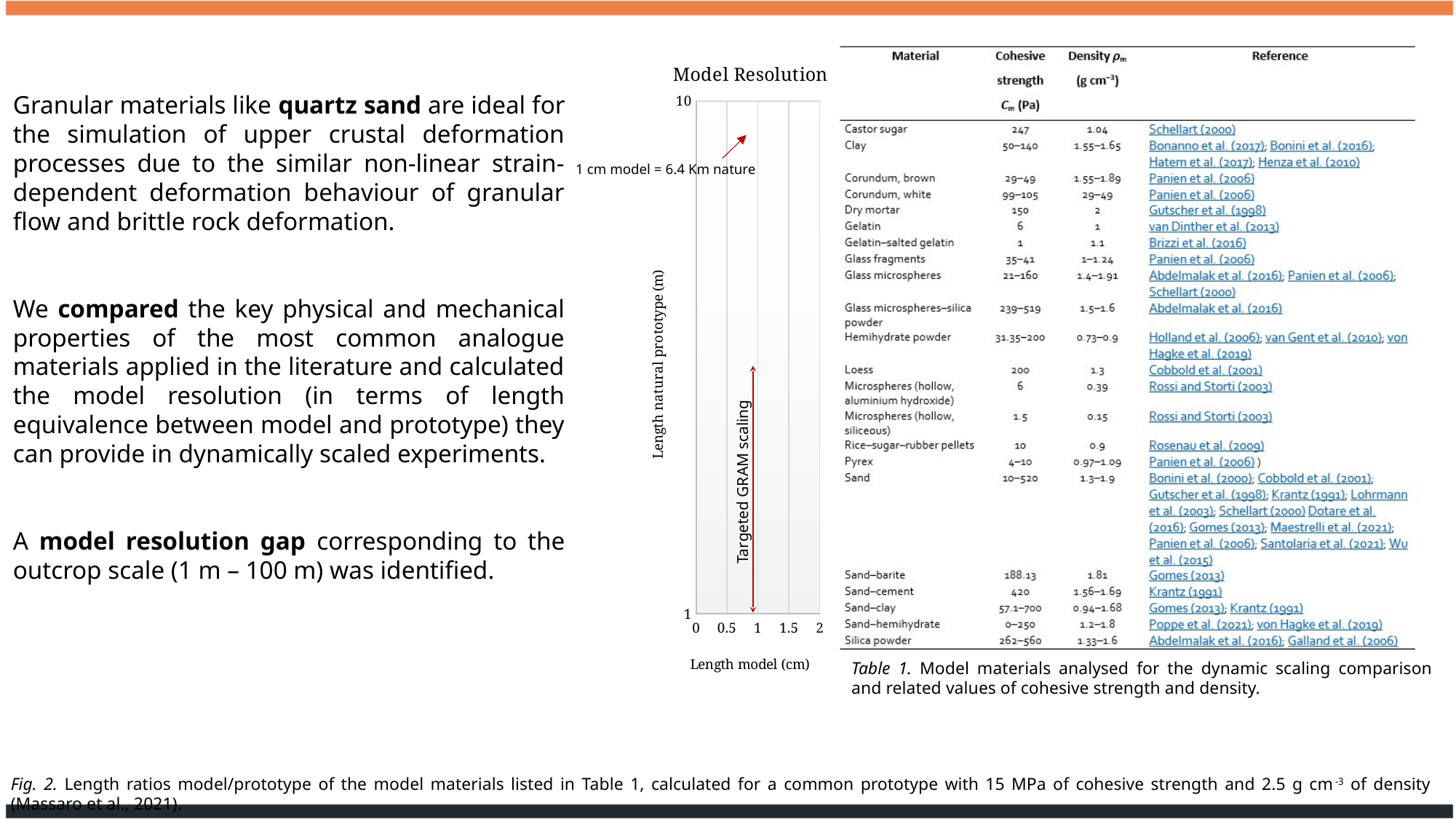
What is the title of the chart on the slide? Model Resolution According to the annotation on the Model Resolution chart, 1 cm in the model corresponds to what length in nature? 6.4 Km What is the label of the y axis of the Model Resolution chart? Length natural prototype (m)